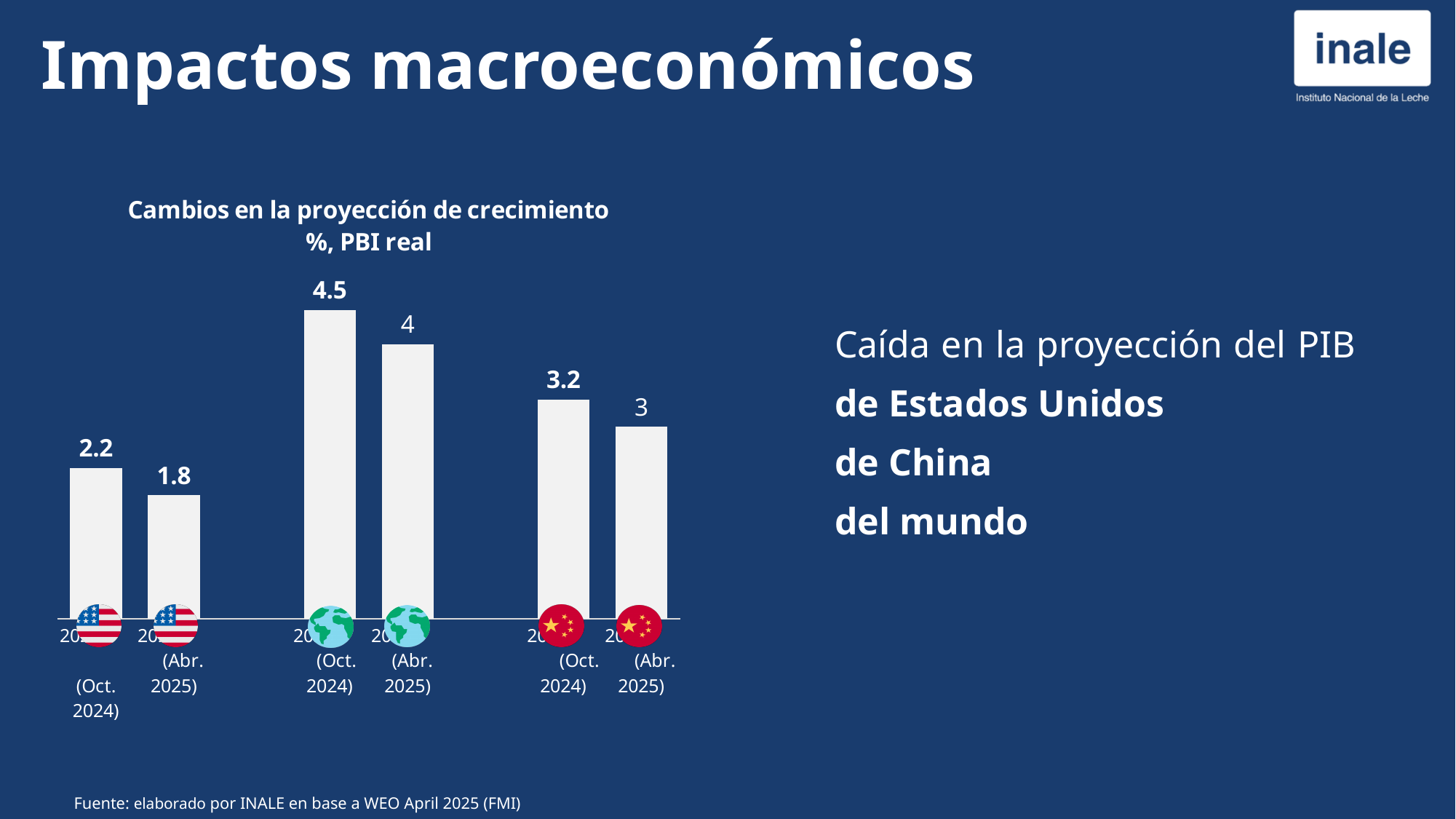
What is the value of the bar with the China flag labelled Oct. 2024? 3.2 What is the value of the bar with the globe icon labelled Oct. 2024? 4.5 What is the value of the first bar (US flag, Oct. 2024)? 2.2 What is the value of the bar with the globe icon labelled Abr. 2025? 4 Which bar has the lowest value in the chart? US flag, Abr. 2025 (1.8) What is the value of the second bar (US flag, Abr. 2025)? 1.8 How many bars are plotted in the chart? 6 What type of chart is shown on the slide? bar chart What is the difference between the Oct. 2024 and Abr. 2025 bars with the US flag? 0.4 Which bar has the highest value in the chart? Globe icon, Oct. 2024 (4.5) What is the value of the bar with the China flag labelled Abr. 2025? 3 What is the title of the chart? Cambios en la proyección de crecimiento %, PBI real